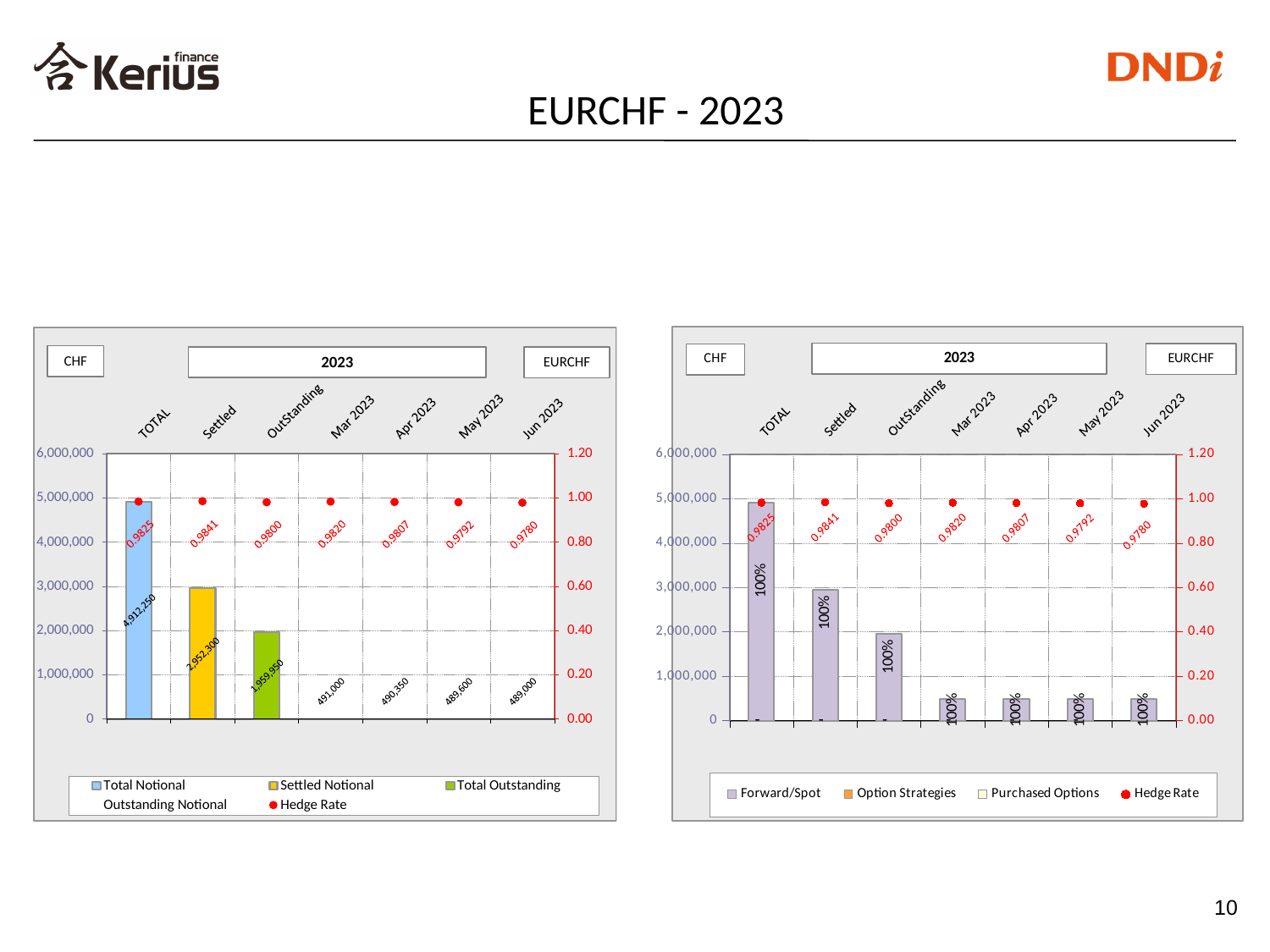
In the left chart, does the Hedge Rate rise or fall from Mar 2023 to Jun 2023? fall In the left chart, which is larger, the value for Mar 2023 or the value for Jun 2023? Mar 2023 In the left chart, which category has the highest Hedge Rate? Settled In the left chart, which category has the lowest Hedge Rate? Jun 2023 In the left chart, what is the value of the Settled bar? 2,952,300 In the left chart, what is the value of the TOTAL bar? 4,912,250 In the left chart, what is the Hedge Rate for Mar 2023? 0.9820 In the left chart, what is the difference between the Settled value and the OutStanding value? 992,350 In the right chart, what percentage is labelled on the Forward/Spot bar for Apr 2023? 100% How many series does the legend of the right chart list? 4 How many categories are shown on the x axis of the left chart? 7 In the left chart, what is the value of the OutStanding bar? 1,959,950